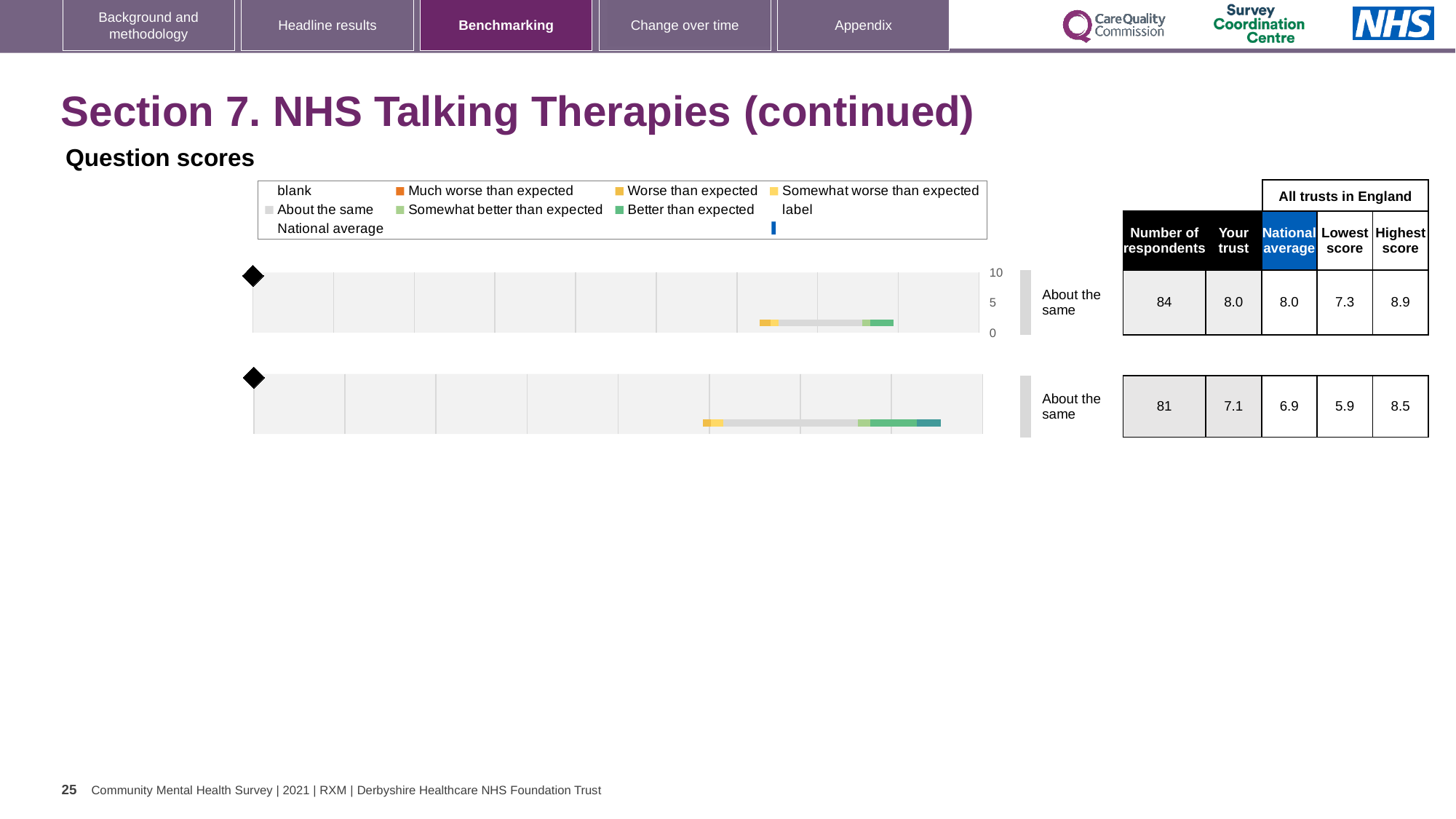
What kind of chart is used on this slide to show the question scores? bar chart In the legend, which category is shown in orange? Much worse than expected What is the highest value shown on the vertical axis next to the top chart? 10 For the bottom chart, what is the difference between the highest score and the lowest score? 2.6 For the top chart, what is the 'Your trust' score? 8.0 For the bottom chart, which is larger: the 'Your trust' score or the national average? Your trust For the top chart, what is the difference between the highest score and the lowest score? 1.6 For the top chart, what is the national average score? 8.0 For the top chart, what is the number of respondents? 84 For the bottom chart, what is the highest score among all trusts in England? 8.5 For the bottom chart, what is the number of respondents? 81 How many question score charts are shown on the slide? 2